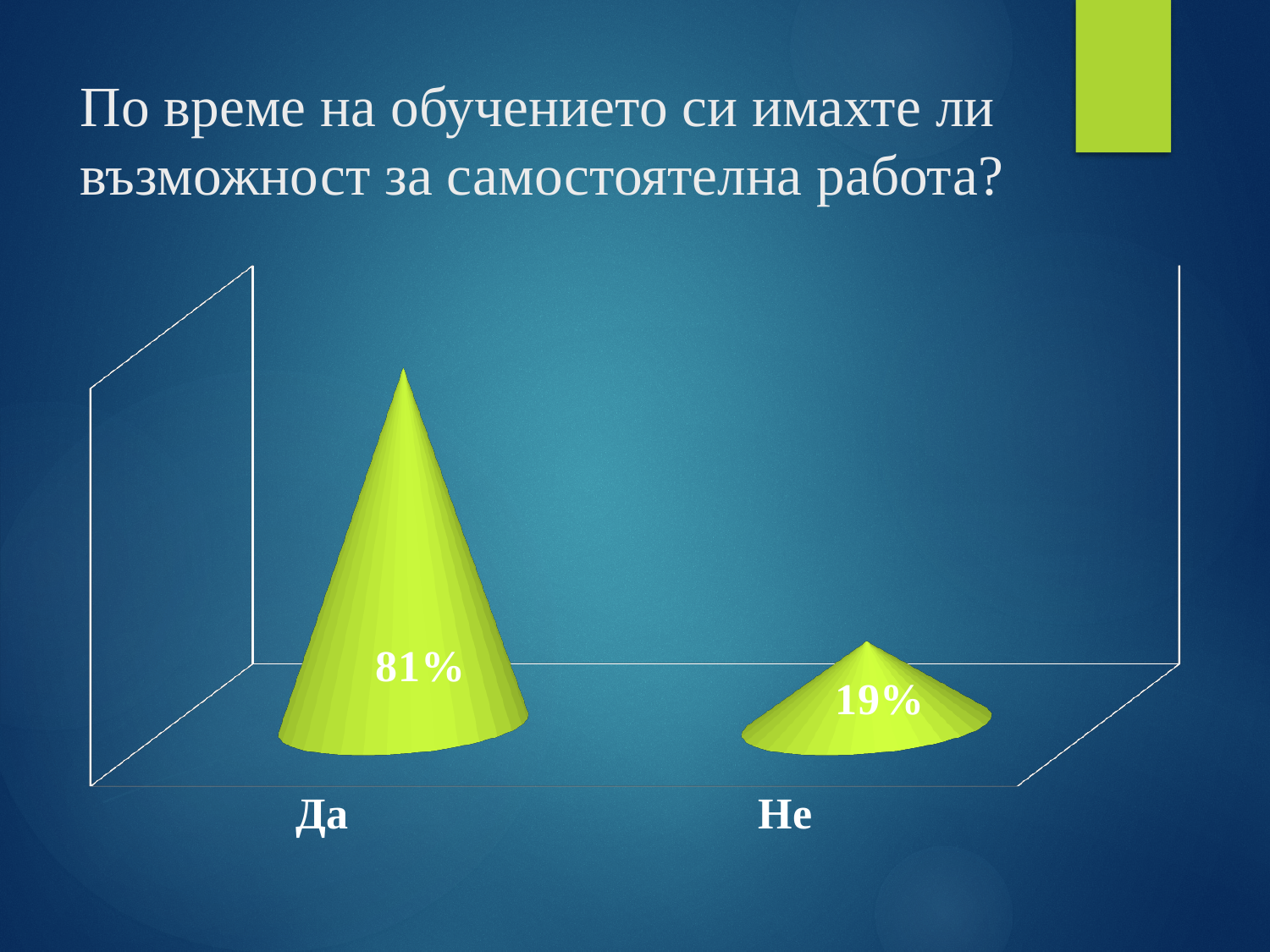
What is the value for "Да"? 81% Which is larger, the value for "Да" or the value for "Не"? Да What colour are the bars in the chart? Green What is the difference between the values for "Да" and "Не"? 62% What is the total of the two values shown in the chart? 100% What is the value for "Не"? 19% How many categories are shown in the chart? 2 Which category has the lowest value? Не Which category has the highest value? Да What kind of chart is shown on the slide? Bar chart What question does the slide title ask? По време на обучението си имахте ли възможност за самостоятелна работа?